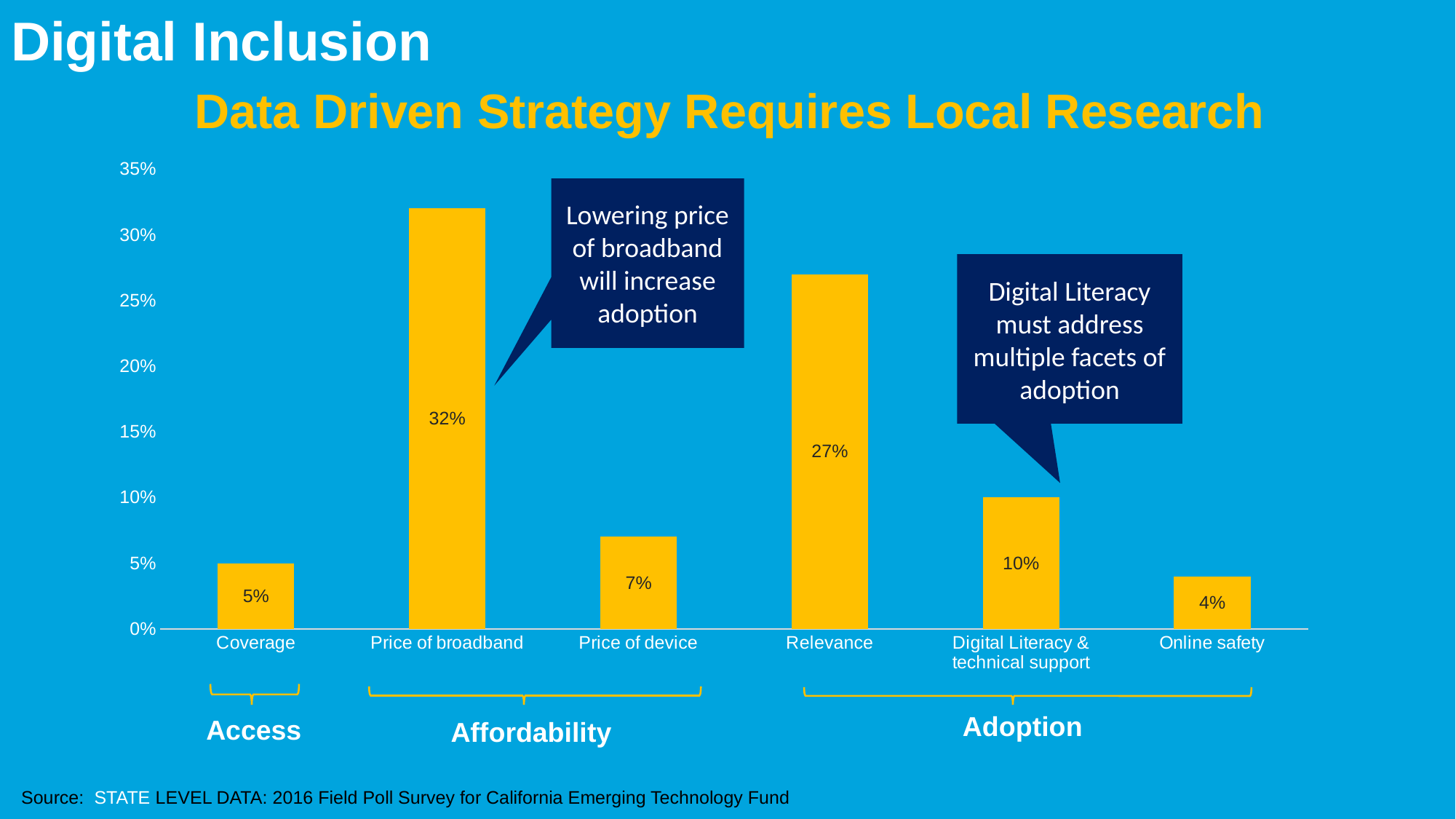
What is the value for Price of broadband? 32% What kind of chart is shown on the slide? Bar chart Which category has the highest value? Price of broadband What is the value for Coverage? 5% What is the difference between the values for Price of broadband and Relevance? 5% What is the value for Online safety? 4% How many categories are shown on the x axis? 6 What is the difference between the values for Digital Literacy & technical support and Price of device? 3% What is the value for Digital Literacy & technical support? 10% Which is larger, the value for Relevance or the value for Price of device? Relevance Which category has the lowest value? Online safety Which group label covers the Price of broadband and Price of device bars? Affordability